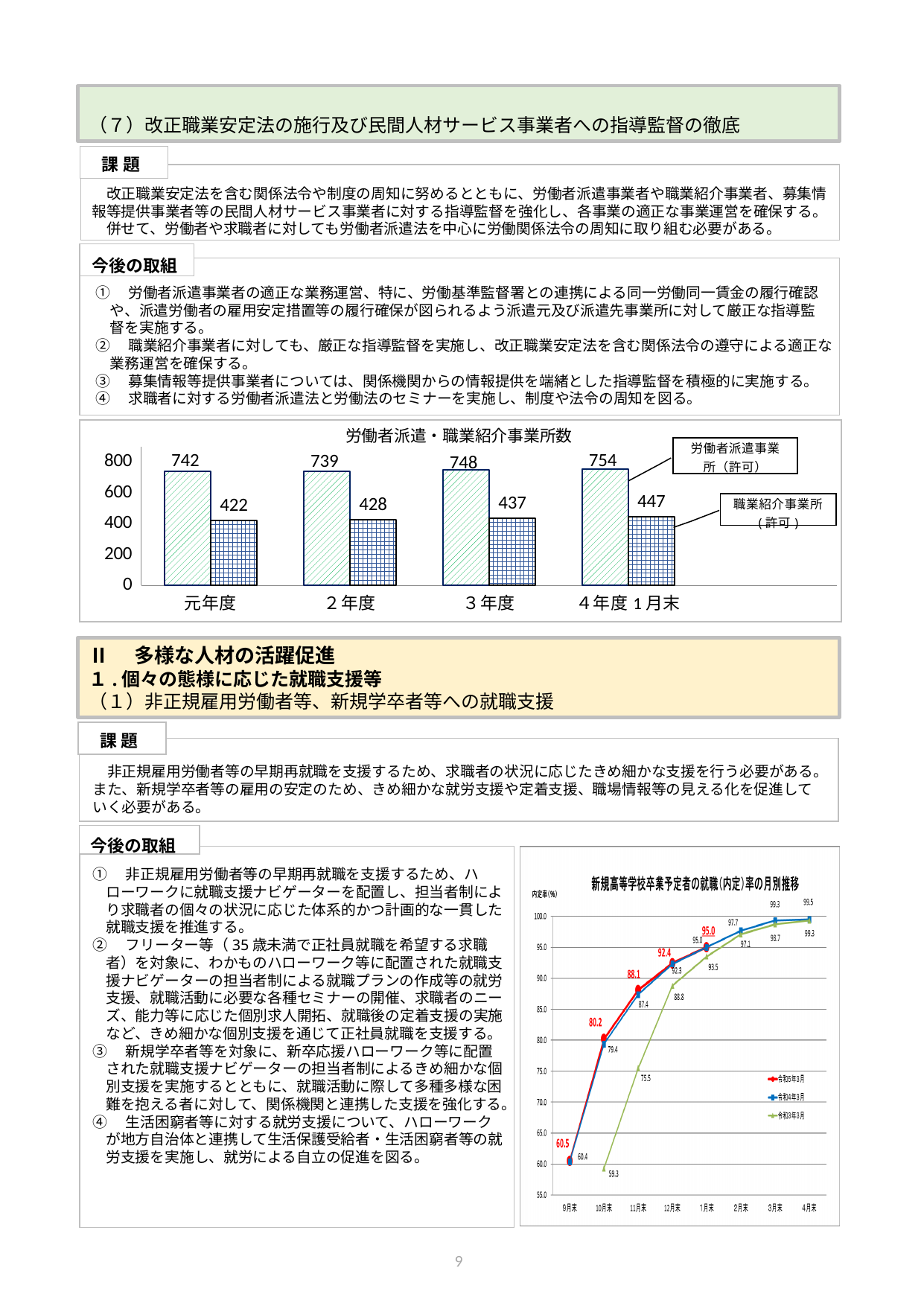
In the bar chart titled 労働者派遣・職業紹介事業所数, how many series are shown? 2 In the bar chart titled 労働者派遣・職業紹介事業所数, what is the value for 職業紹介事業所（許可） in ３年度? 437 In the bar chart titled 労働者派遣・職業紹介事業所数, what is the difference between the 労働者派遣事業所（許可） and 職業紹介事業所（許可） values in ４年度１月末? 307 In the bar chart titled 労働者派遣・職業紹介事業所数, how many categories are shown on the x axis? 4 In the bar chart titled 労働者派遣・職業紹介事業所数, what is the value for 労働者派遣事業所（許可） in 元年度? 742 In the bar chart titled 労働者派遣・職業紹介事業所数, do the values for 職業紹介事業所（許可） rise or fall from 元年度 to ４年度１月末? rise What kind of chart is the chart titled 労働者派遣・職業紹介事業所数? bar chart In the line chart titled 新規高等学校卒業予定者の就職(内定)率の月別推移, how many series does the legend list? 3 In the bar chart titled 労働者派遣・職業紹介事業所数, which category has the lowest value for 職業紹介事業所（許可）? 元年度 In the bar chart titled 労働者派遣・職業紹介事業所数, which category has the highest value for 労働者派遣事業所（許可）? ４年度１月末 What kind of chart is the chart titled 新規高等学校卒業予定者の就職(内定)率の月別推移? line chart In the line chart titled 新規高等学校卒業予定者の就職(内定)率の月別推移, what is the value for 令和5年3月 at 9月末? 60.5